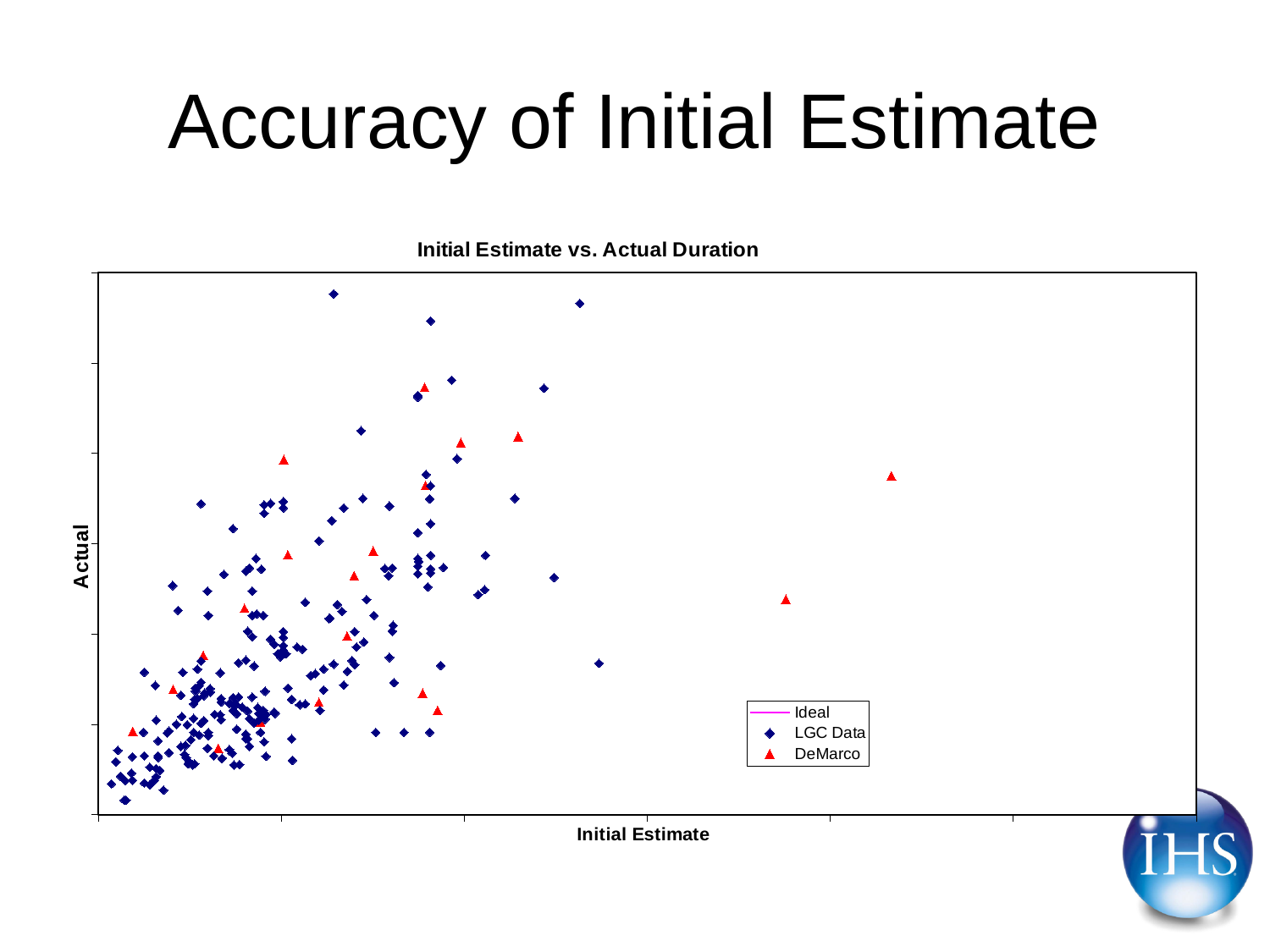
Which series in the chart is plotted with red triangles? DeMarco What is the title of the chart? Initial Estimate vs. Actual Duration Which series has more plotted points, LGC Data or DeMarco? LGC Data How many series does the legend of the chart list? 3 What kind of chart is shown on the slide? scatter chart Do the Actual values generally rise or fall as the Initial Estimate increases along the x axis? rise